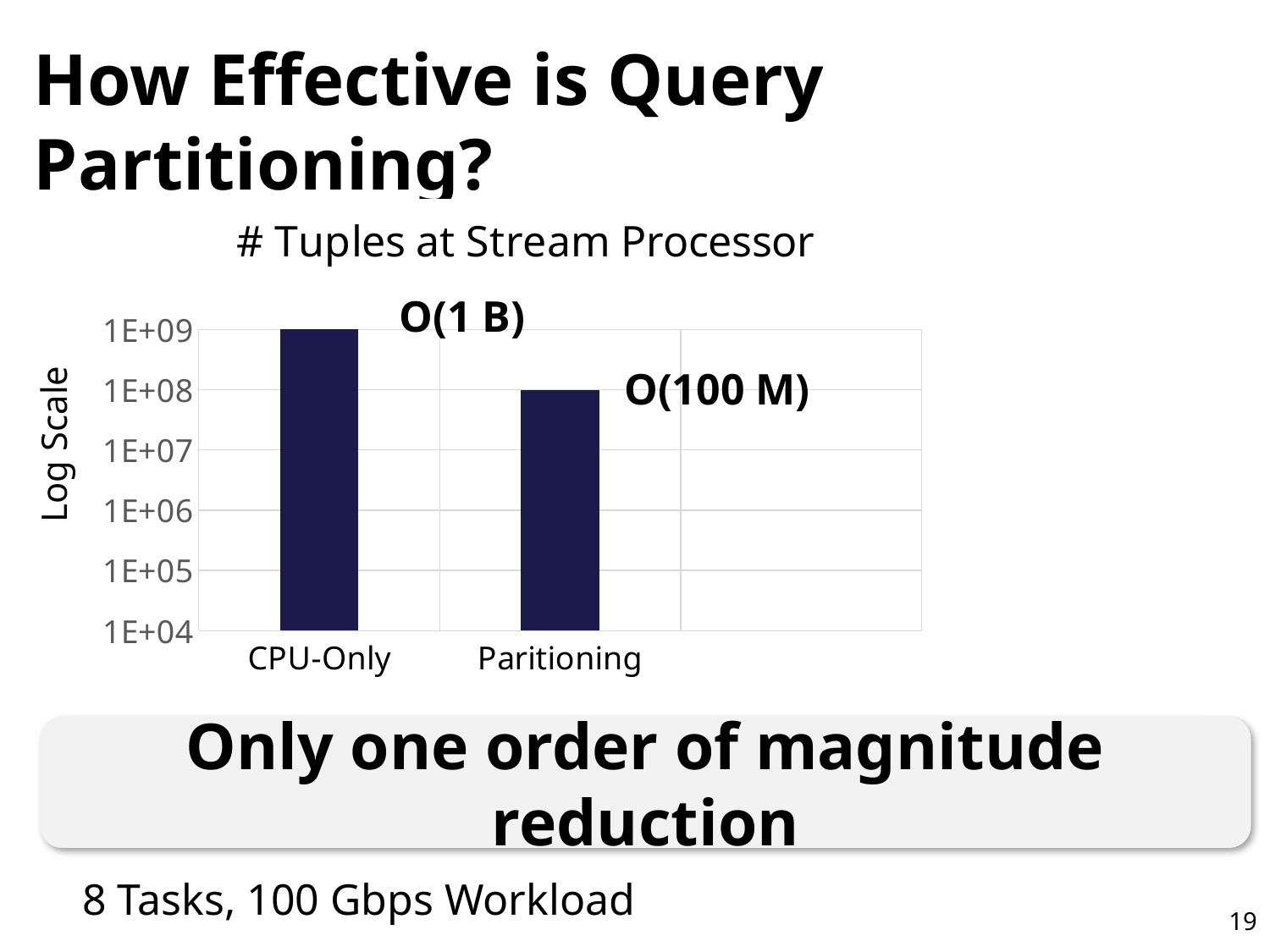
How many bars (categories) does the chart show? 2 Which axis tick does the Paritioning bar reach on the y axis? 1E+08 What annotation label is printed next to the Paritioning bar? O(100 M) Which is larger, the value for CPU-Only or the value for Paritioning? CPU-Only Which category has the lowest number of tuples at the stream processor? Paritioning Which axis tick does the CPU-Only bar reach on the y axis? 1E+09 What type of chart is shown on the slide? bar chart Which category has the highest number of tuples at the stream processor? CPU-Only What annotation label is printed next to the CPU-Only bar? O(1 B) Is the value for Paritioning greater or less than 1E+09? less What is the label on the y axis of the chart? Log Scale What is the title of the chart? # Tuples at Stream Processor